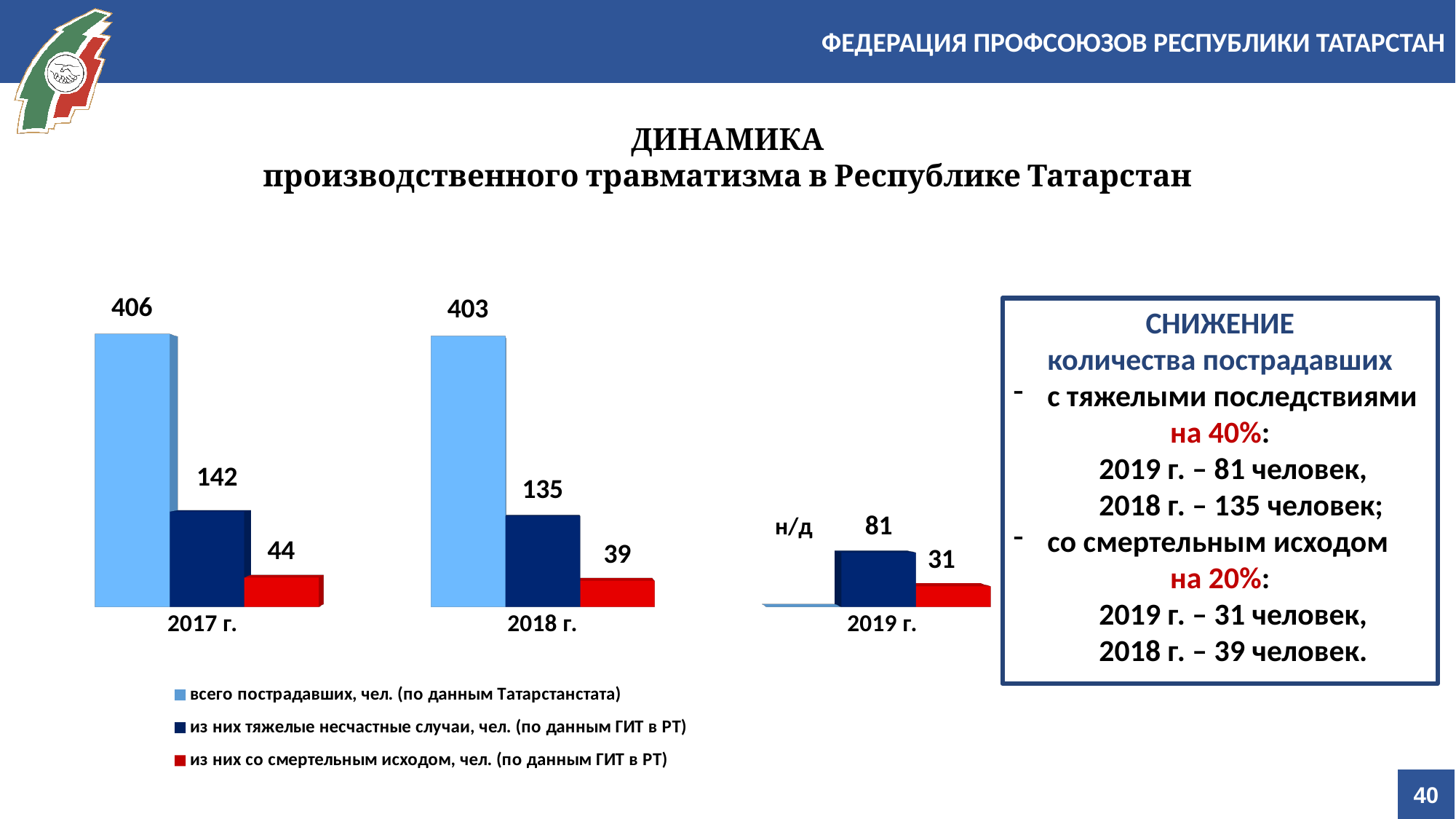
How many series does the legend list? 3 Do the values for 'из них тяжелые несчастные случаи' rise or fall from 2017 г. to 2019 г.? fall What kind of chart is shown on the slide? bar chart What is the value for 'из них тяжелые несчастные случаи' in 2018 г.? 135 What is shown for 'всего пострадавших' in 2019 г.? н/д What is the difference between the 'из них тяжелые несчастные случаи' values for 2018 г. and 2019 г.? 54 Which is larger: 'из них со смертельным исходом' in 2017 г. or in 2018 г.? 2017 г. What is the value for 'всего пострадавших' in 2017 г.? 406 What is the value for 'из них со смертельным исходом' in 2019 г.? 31 How many years are shown on the x axis? 3 Which year has the lowest value for 'из них со смертельным исходом'? 2019 г. Which year has the highest value for 'из них тяжелые несчастные случаи'? 2017 г.